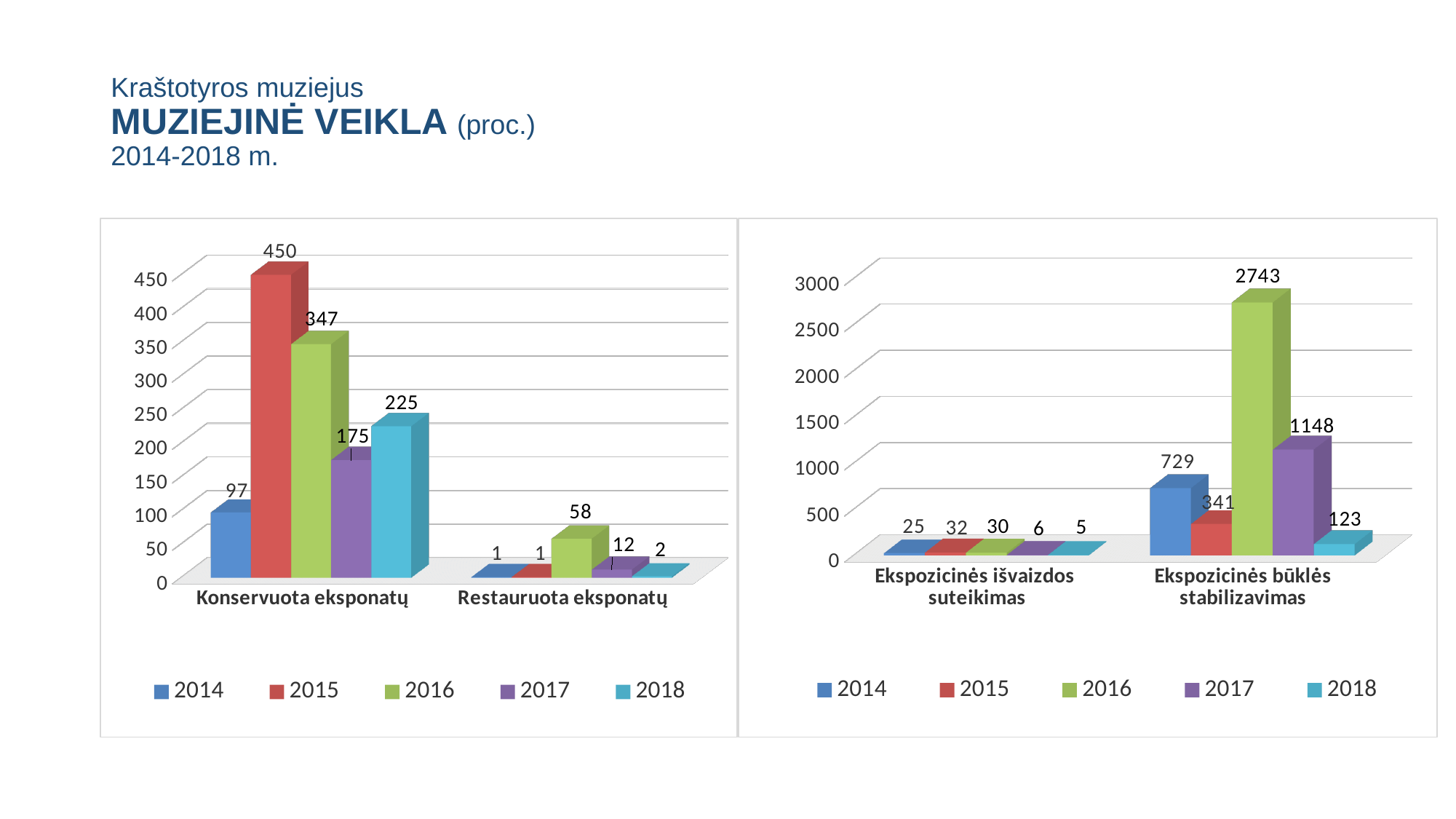
In the left chart, what is the difference between the 2015 and 2014 values for Konservuota eksponatų? 353 In the left chart, which year has the highest value for Konservuota eksponatų? 2015 In the right chart, what is the value for 2018 in the Ekspozicinės išvaizdos suteikimas category? 5 In the left chart, how many series does the legend list? 5 In the right chart, how many categories are shown on the x axis? 2 What kind of chart is the right chart? Bar chart In the right chart, what is the value for 2016 in the Ekspozicinės būklės stabilizavimas category? 2743 In the left chart, which is larger for Konservuota eksponatų: the 2017 value or the 2018 value? 2018 In the left chart, what is the value for 2016 in the Restauruota eksponatų category? 58 In the right chart, which year has the lowest value for Ekspozicinės būklės stabilizavimas? 2018 In the left chart, what is the value for 2015 in the Konservuota eksponatų category? 450 In the right chart, what is the difference between the 2016 and 2017 values for Ekspozicinės būklės stabilizavimas? 1595